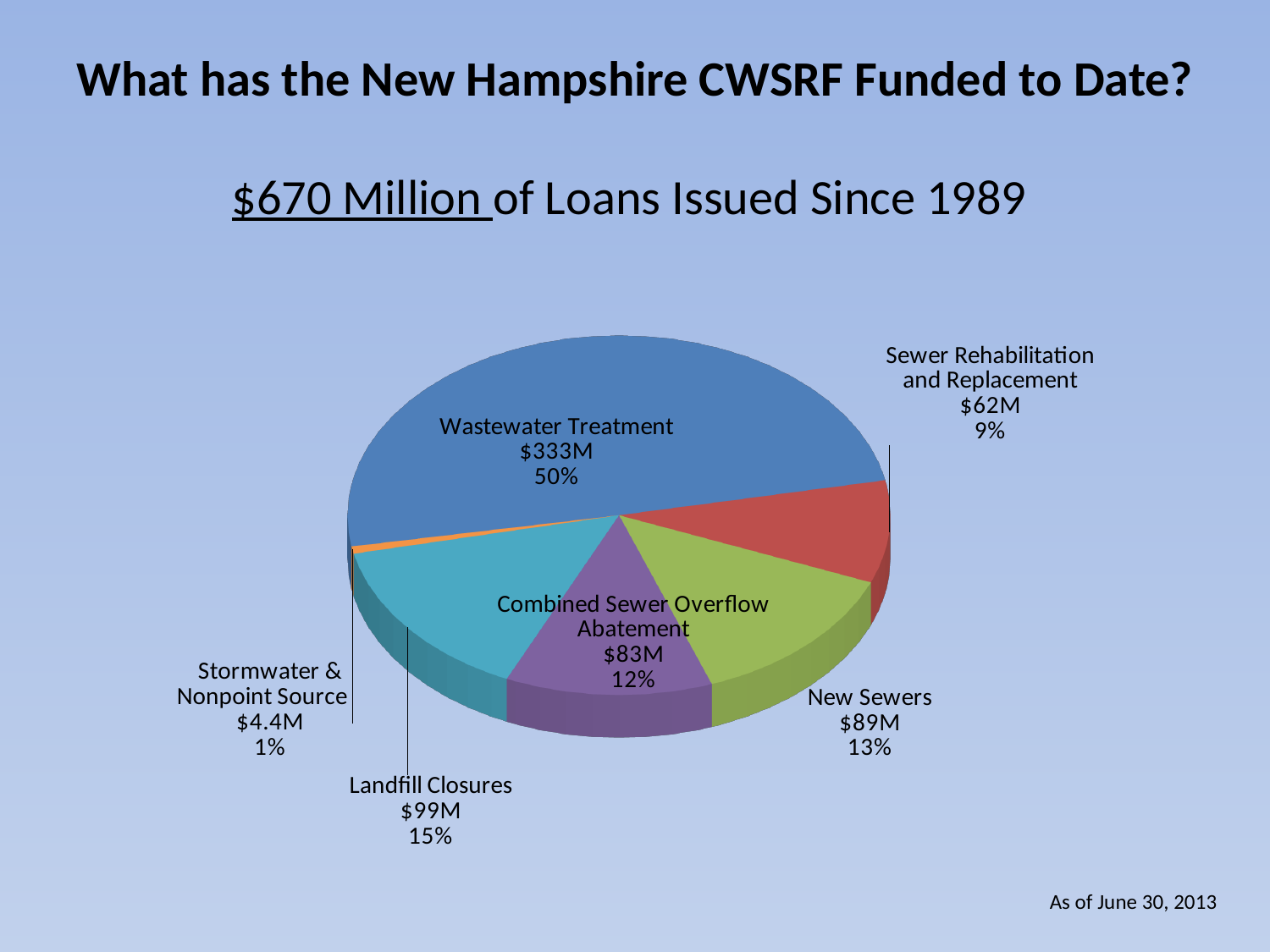
What percentage share does Sewer Rehabilitation and Replacement have? 9% What dollar amount is shown for New Sewers? $89M What dollar amount is shown for Stormwater & Nonpoint Source? $4.4M How many categories does the pie chart show? 6 Which category has the smallest share of the pie? Stormwater & Nonpoint Source Which category has the largest share of the pie? Wastewater Treatment What percentage share does Landfill Closures have? 15% Which is larger, New Sewers or Sewer Rehabilitation and Replacement? New Sewers What is the difference in dollars between Landfill Closures and Combined Sewer Overflow Abatement? $16M What dollar amount is shown for Wastewater Treatment? $333M What type of chart is shown on the slide? pie chart What total amount of loans issued since 1989 is stated on the slide? $670 Million